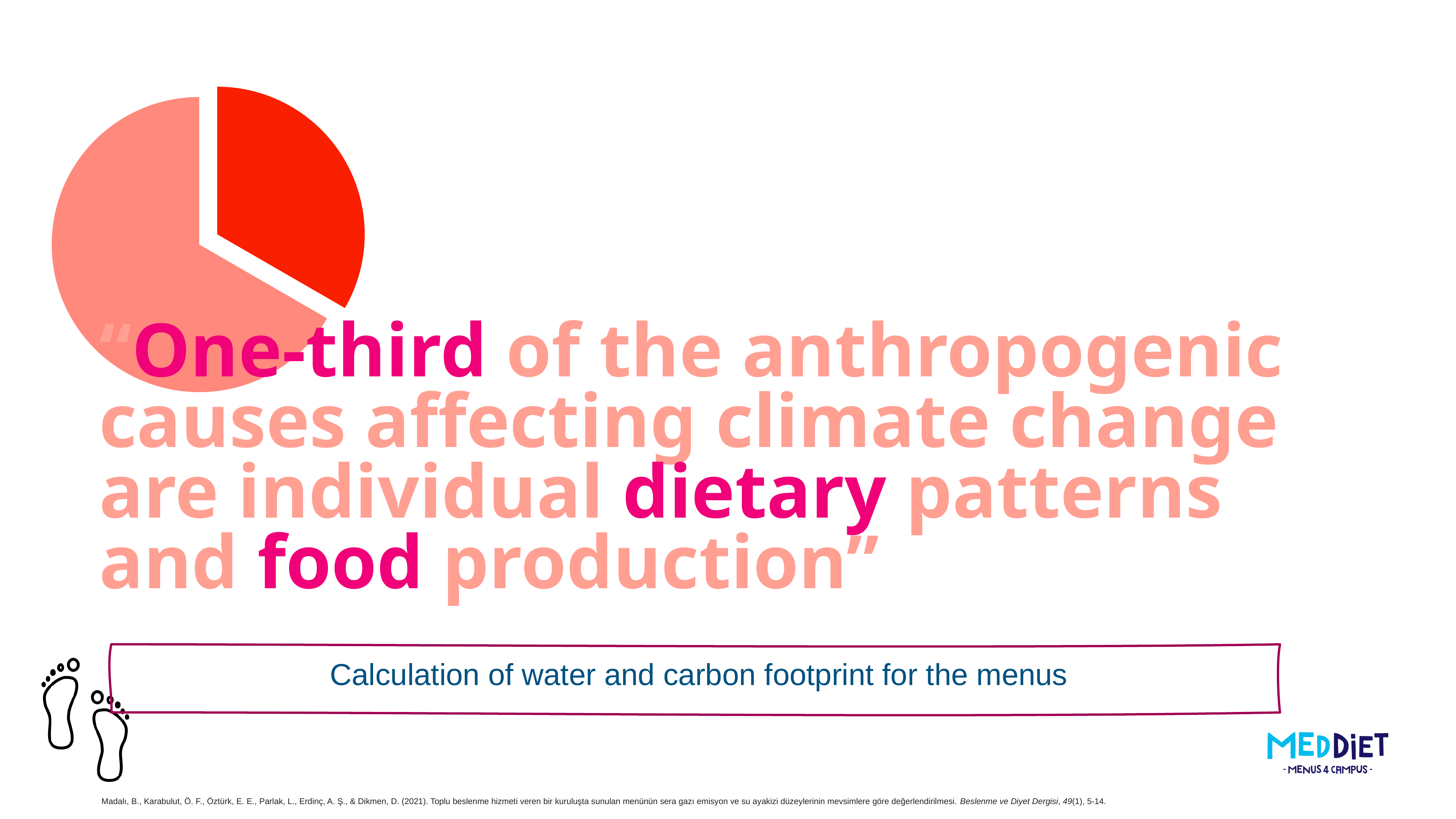
What colour is the exploded slice of the pie chart? red Which slice of the pie chart is larger, the light pink slice or the red exploded slice? the light pink slice What kind of chart is shown on the slide? pie chart Does the pie chart have a legend? No Which slice of the pie chart is the smallest? the red exploded slice What share of the pie does the red exploded slice represent, according to the slide text? One-third How many slices does the pie chart have? 2